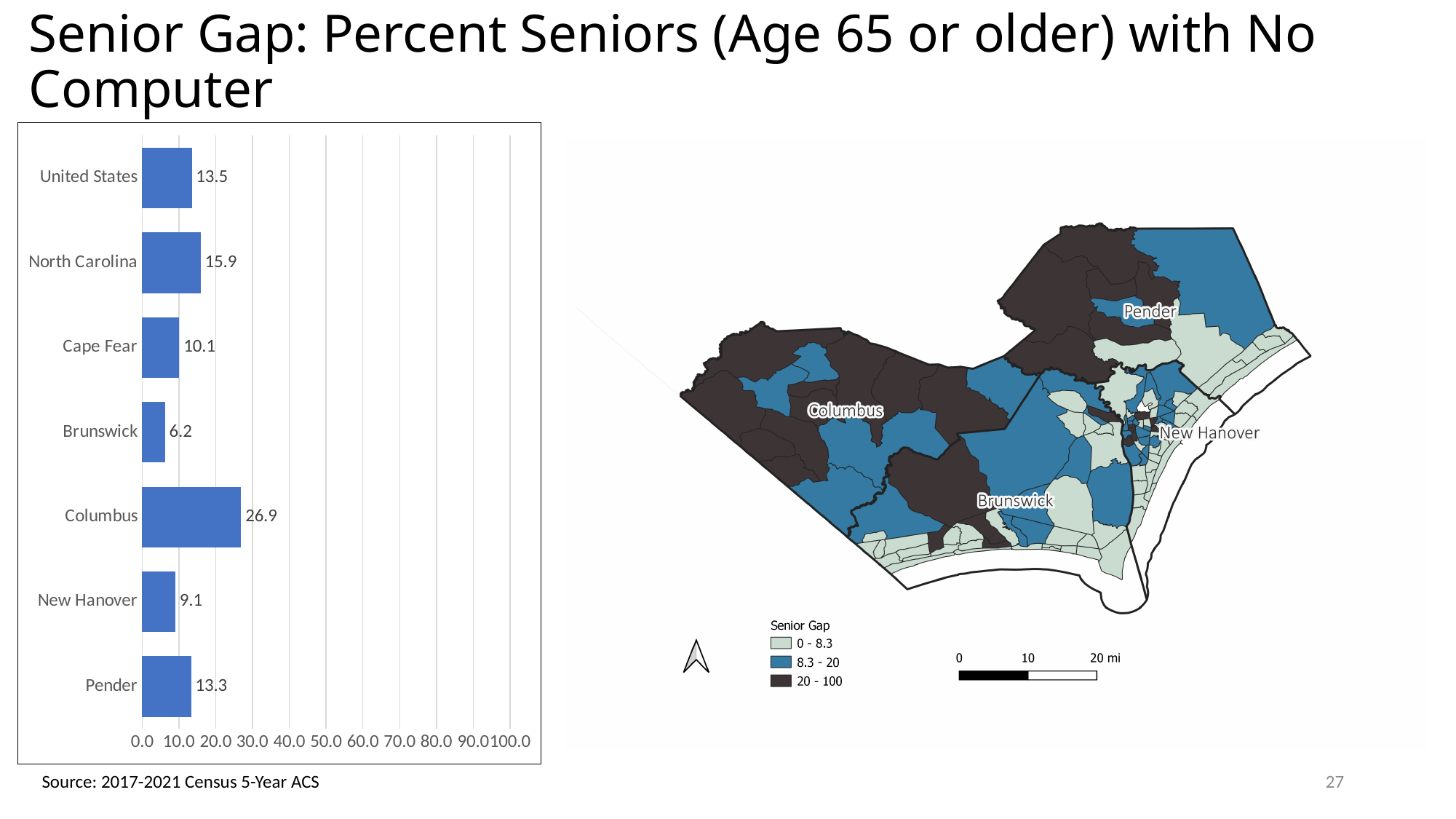
In the bar chart, is the value for Cape Fear greater or less than 20.0? less In the bar chart, which category has the highest value? Columbus How many categories are shown in the bar chart? 7 In the bar chart, what is the value for North Carolina? 15.9 In the bar chart, what is the value for Columbus? 26.9 What is the highest value shown on the x axis of the bar chart? 100.0 In the bar chart, what is the difference between the values for Columbus and Brunswick? 20.7 In the bar chart, which category has the lowest value? Brunswick In the bar chart, what is the difference between the values for North Carolina and United States? 2.4 In the bar chart, what is the value for Brunswick? 6.2 What kind of chart is shown on the left of the slide? bar chart In the bar chart, which is larger, the value for United States or the value for Pender? United States